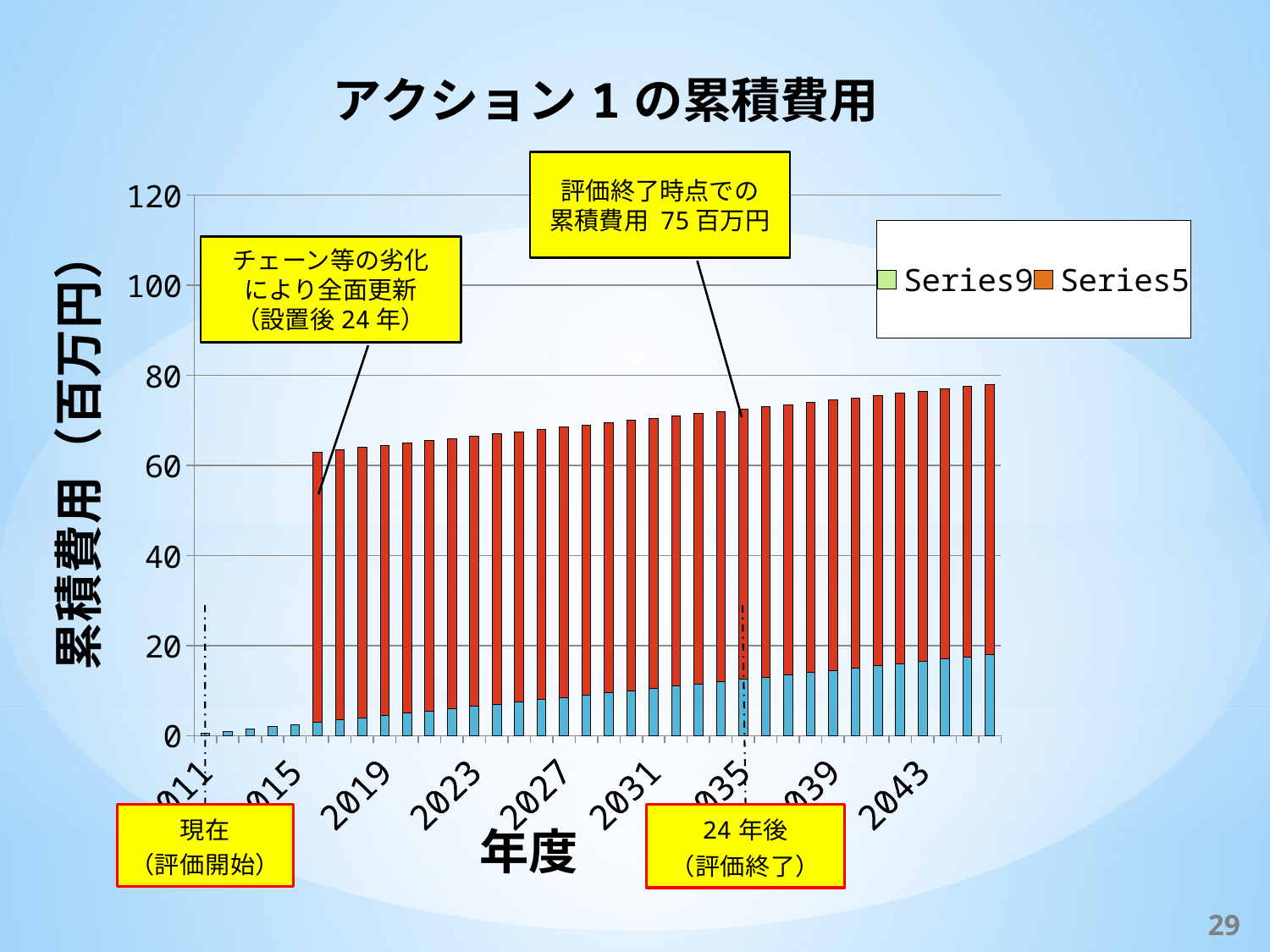
What is the title of the chart? アクション１の累積費用 Is the total value of the bar for 2031 greater or less than 60? greater Do the bar totals rise or fall from 2017 to 2043 along the x axis? rise According to the annotation, what is the cumulative cost at the end of the evaluation period? 75 百万円 How many series does the legend list? 2 Is the total value of the bar for 2043 greater or less than 80? less What kind of chart is shown on the slide? stacked bar chart Is the total value of the bar for 2015 greater or less than 20? less What is the highest tick value shown on the y axis? 120 What are the two series names shown in the legend? Series9 and Series5 Which bar is taller, the one for 2019 or the one for 2043? 2043